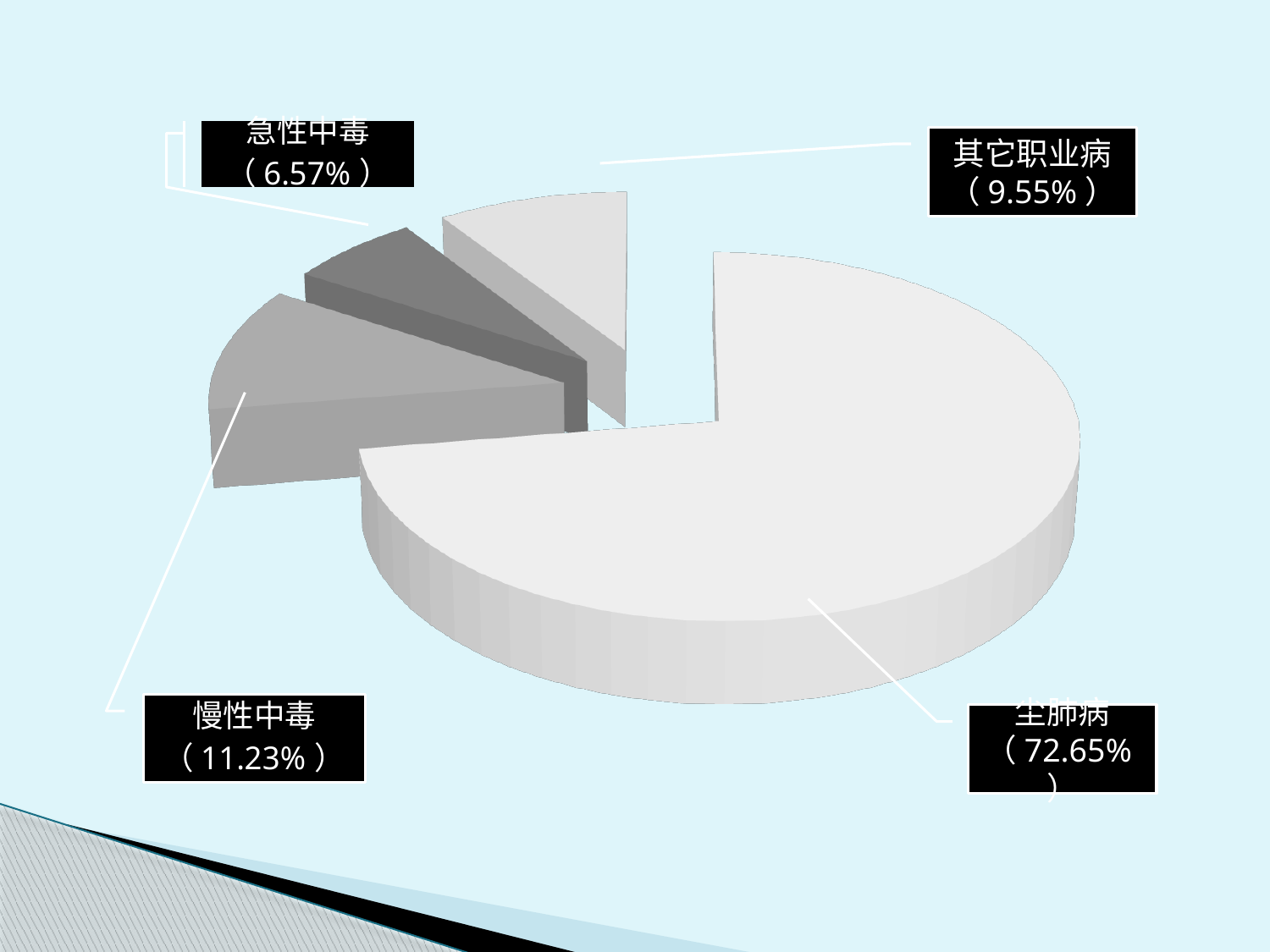
What share of the pie does 尘肺病 account for? 72.65% What is the difference in percentage points between the shares of 慢性中毒 and 急性中毒? 4.66 How many slices does the pie chart have? 4 What share of the pie does 急性中毒 account for? 6.57% What is the difference in percentage points between the shares of 尘肺病 and 其它职业病? 63.1 Which category has the smallest slice of the pie? 急性中毒 Which is larger, the share for 慢性中毒 or the share for 其它职业病? 慢性中毒 What share of the pie does 其它职业病 account for? 9.55% What kind of chart is shown on the slide? pie chart Which slice of the pie is drawn in the darkest grey? 急性中毒 Which category has the largest slice of the pie? 尘肺病